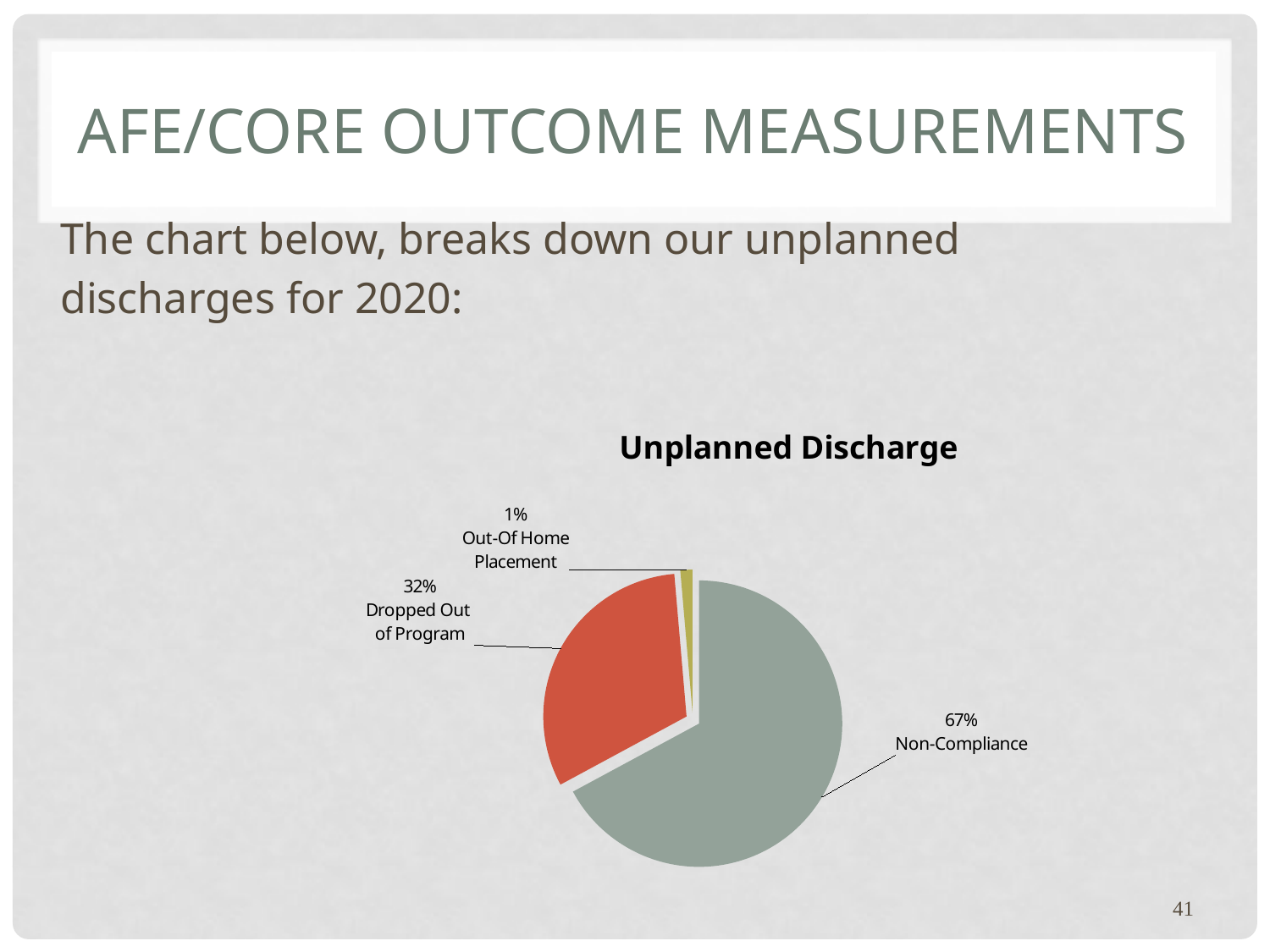
How many categories are shown in the pie chart? 3 What type of chart is shown on the slide? pie chart What is the difference in percentage points between Non-Compliance and Dropped Out of Program? 35 Which category has the smallest share of unplanned discharges? Out-Of Home Placement What colour is the Non-Compliance slice? grey-green What is the title of the chart? Unplanned Discharge Which category has the largest share of unplanned discharges? Non-Compliance What share of unplanned discharges is Out-Of Home Placement? 1% What share of unplanned discharges is Non-Compliance? 67% What share of unplanned discharges is Dropped Out of Program? 32% Which is larger, the share for Dropped Out of Program or the share for Out-Of Home Placement? Dropped Out of Program What is the difference in percentage points between Dropped Out of Program and Out-Of Home Placement? 31